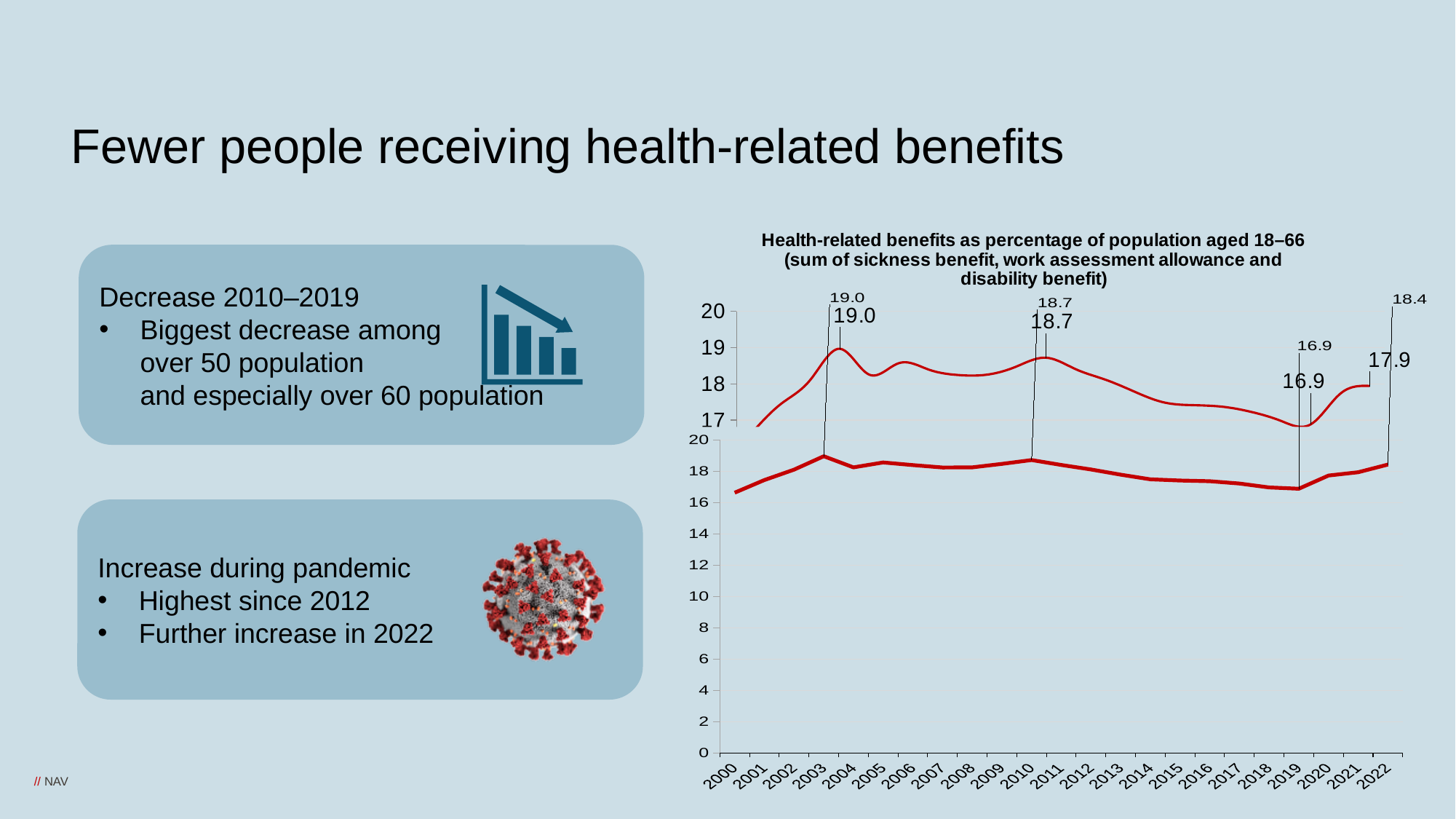
What is the difference between the values for 2003 and 2019? 2.1 What is the value shown for 2019 on the chart? 16.9 What kind of chart is shown on the slide? line chart What is the value shown for 2003 on the chart? 19.0 What is the value shown for 2022 on the chart? 18.4 What is the difference between the values for 2022 and 2019? 1.5 Which is larger, the value for 2010 or the value for 2019? 2010 Which year has the highest labelled value on the chart? 2003 Is the value for 2000 greater or less than 18? less What is the value shown for 2010 on the chart? 18.7 Do the values rise or fall between 2010 and 2019? fall Which year has the lowest labelled value on the chart? 2019